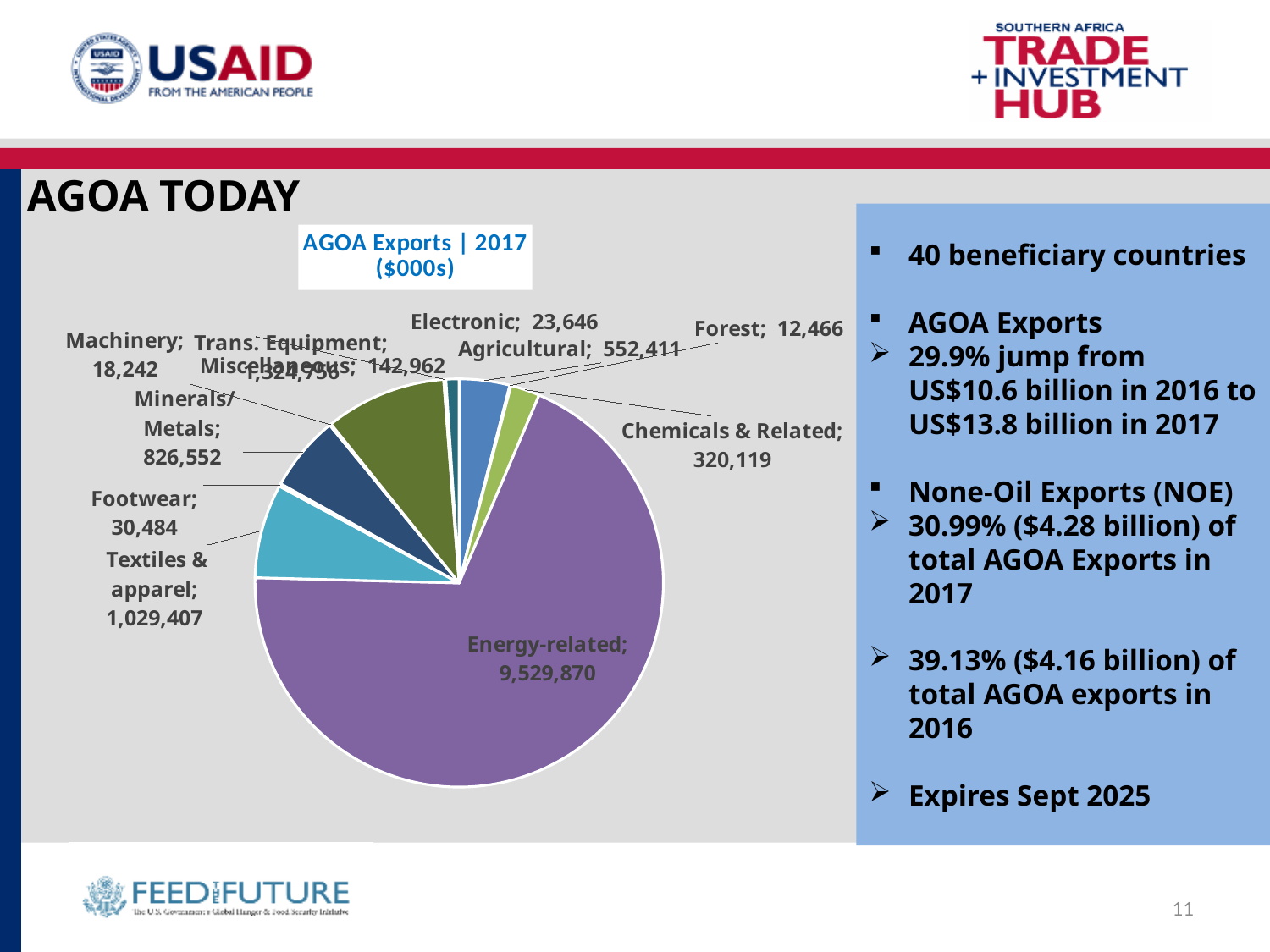
What is the value for Minerals/Metals? 826,552 What is the value for Textiles & apparel? 1,029,407 Which is larger, the value for Agricultural or the value for Chemicals & Related? Agricultural What is the value for Agricultural? 552,411 Which category has the smallest value in the pie chart? Forest What is the title of the chart? AGOA Exports | 2017 ($000s) What is the difference between the values for Textiles & apparel and Minerals/Metals? 202,855 Which category has the largest slice of the pie? Energy-related What is the value for Forest? 12,466 How many categories are shown in the pie chart? 11 What kind of chart is shown on the slide? pie chart What is the value for Energy-related? 9,529,870